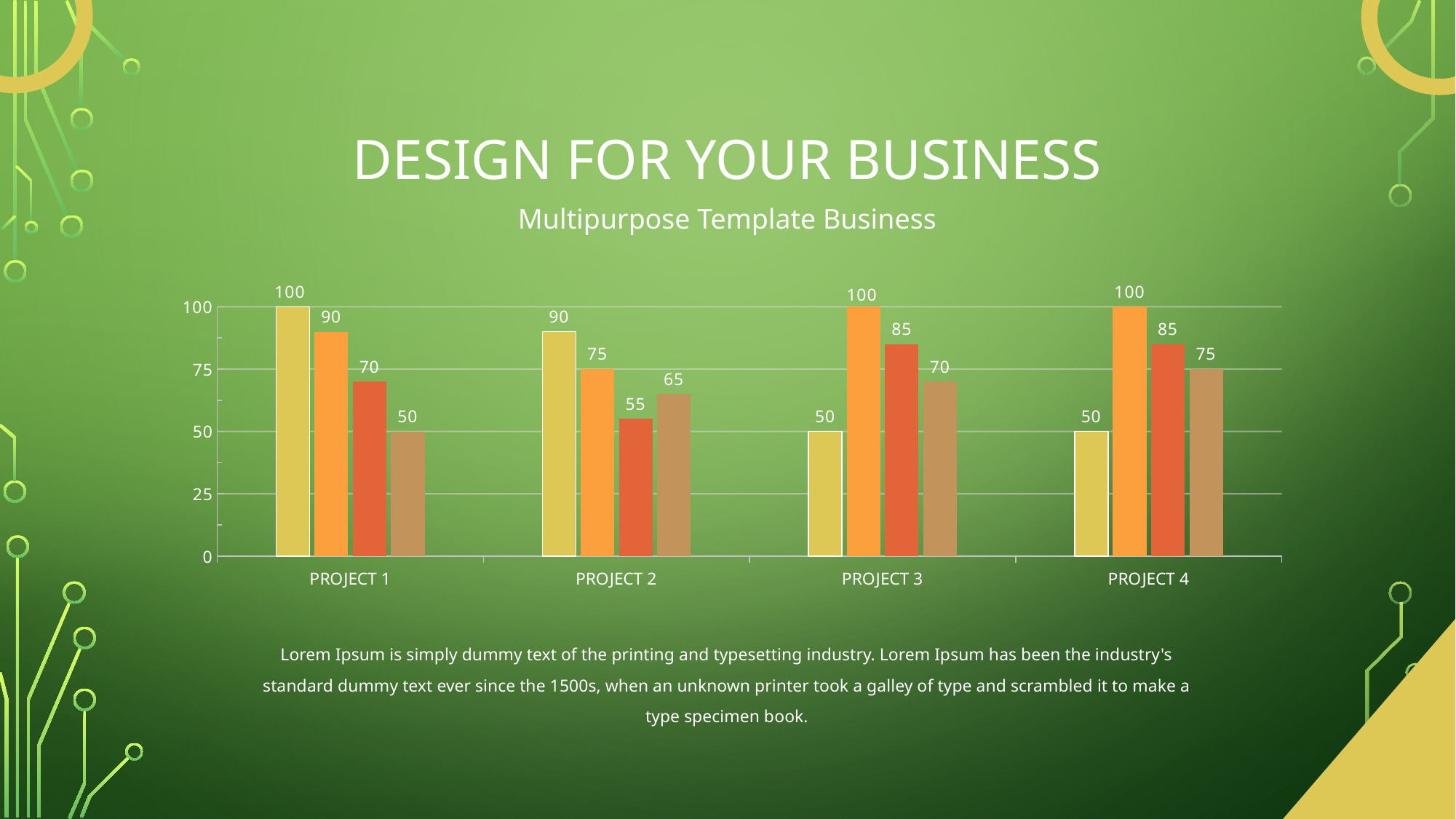
What type of chart is shown on the slide? bar chart What is the value of the third (red) bar for Project 2? 55 Which project has the highest value for the second (orange) bar? Project 3 and Project 4 (both 100) How many bars are plotted for each project in the chart? 4 Which is larger for Project 2: the third (red) bar or the fourth (brown) bar? the fourth (brown) bar What is the value of the first (yellow) bar for Project 1? 100 What is the difference between the first (yellow) bar and the fourth (brown) bar for Project 1? 50 Does the value of the first (yellow) bar rise or fall from Project 1 to Project 4? fall Which project has the lowest value for the first (yellow) bar? Project 3 and Project 4 (both 50) How many projects are shown on the x axis of the chart? 4 What is the value of the fourth (brown) bar for Project 4? 75 What is the title of the slide containing the chart? DESIGN FOR YOUR BUSINESS